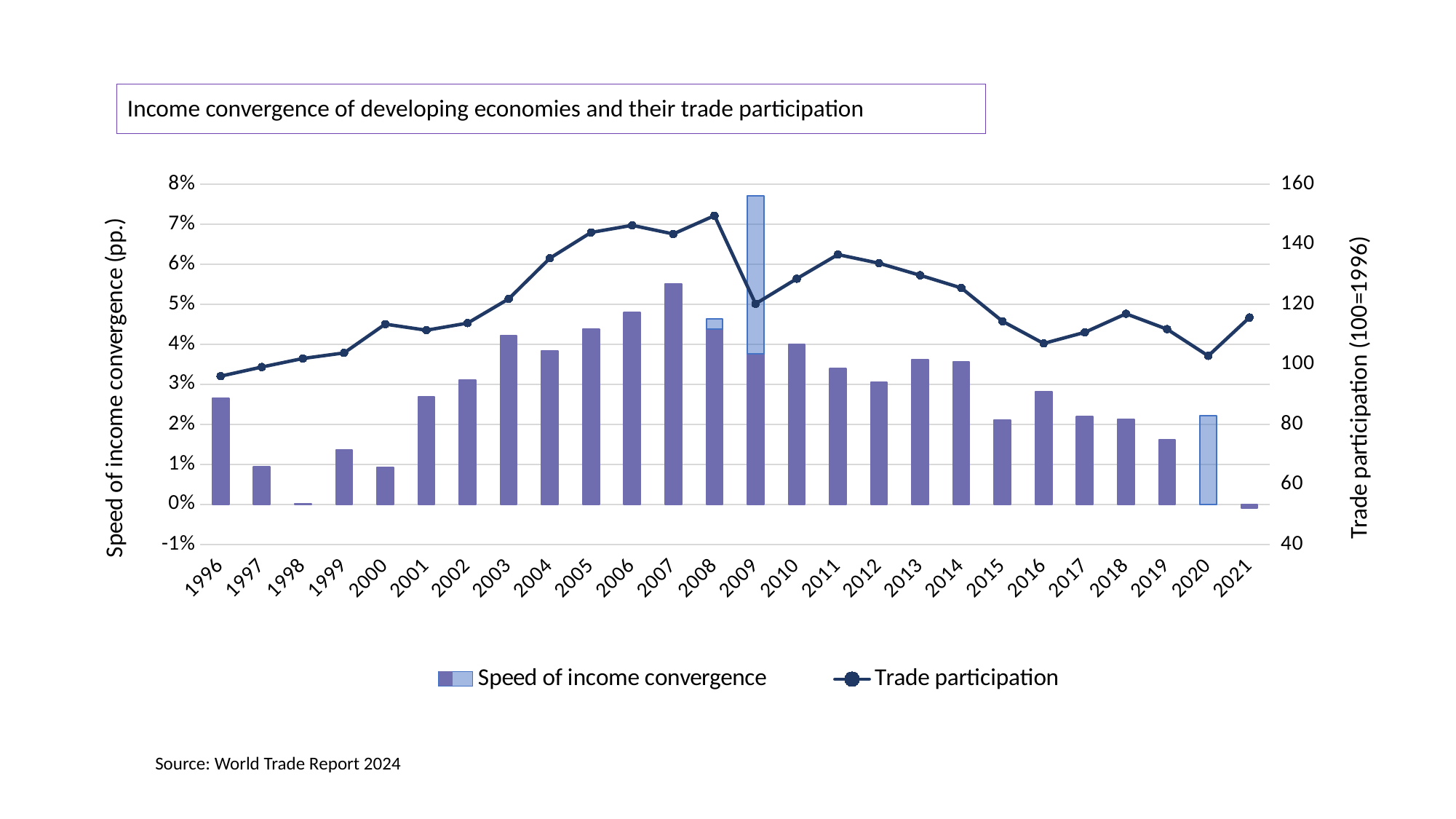
How many years are shown along the x axis? 26 Which year has the larger speed of income convergence bar, 2007 or 2010? 2007 In which year does the trade participation line reach its highest point? 2008 Does the trade participation line rise or fall between 1996 and 2008? It rises Is the speed of income convergence for 2015 greater or less than 3%? less Is the speed of income convergence for 2007 greater or less than 5%? greater In which year is trade participation at its lowest? 1996 How many series does the legend list? 2 Is the trade participation value for 2009 greater or less than 140? less In which year is the speed of income convergence bar the highest? 2009 What kind of chart is shown on the slide? A combination bar and line chart What is the title of the chart? Income convergence of developing economies and their trade participation